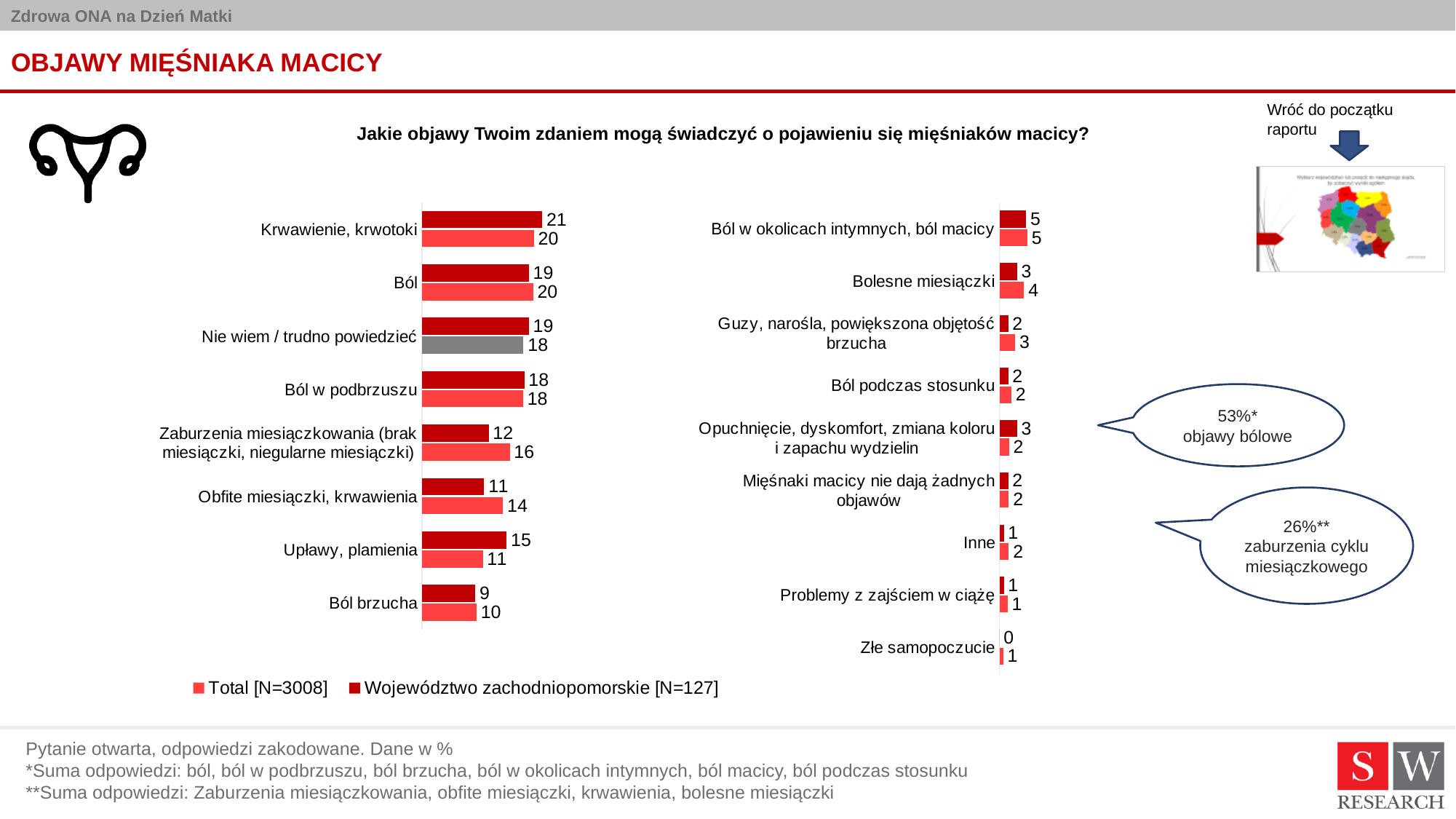
In the right chart, what is the Total [N=3008] value for Guzy, narośla, powiększona objętość brzucha? 3 In the right chart, what is the Total [N=3008] value for Bolesne miesiączki? 4 In the left chart, which category has the highest Województwo zachodniopomorskie [N=127] value? Krwawienie, krwotoki How many categories are shown in the right chart? 9 In the left chart, which category has the lowest Total [N=3008] value? Ból brzucha In the left chart, what is the Total [N=3008] value for Krwawienie, krwotoki? 20 What type of chart is used on this slide? Bar chart How many series does the legend list? 2 In the left chart, what is the Województwo zachodniopomorskie [N=127] value for Upławy, plamienia? 15 In the left chart, for Obfite miesiączki, krwawienia, which series has the larger value: Total [N=3008] or Województwo zachodniopomorskie [N=127]? Total [N=3008] In the left chart, what is the difference between the Total [N=3008] and Województwo zachodniopomorskie [N=127] values for Zaburzenia miesiączkowania (brak miesiączki, niegularne miesiączki)? 4 In the right chart, what is the Województwo zachodniopomorskie [N=127] value for Złe samopoczucie? 0